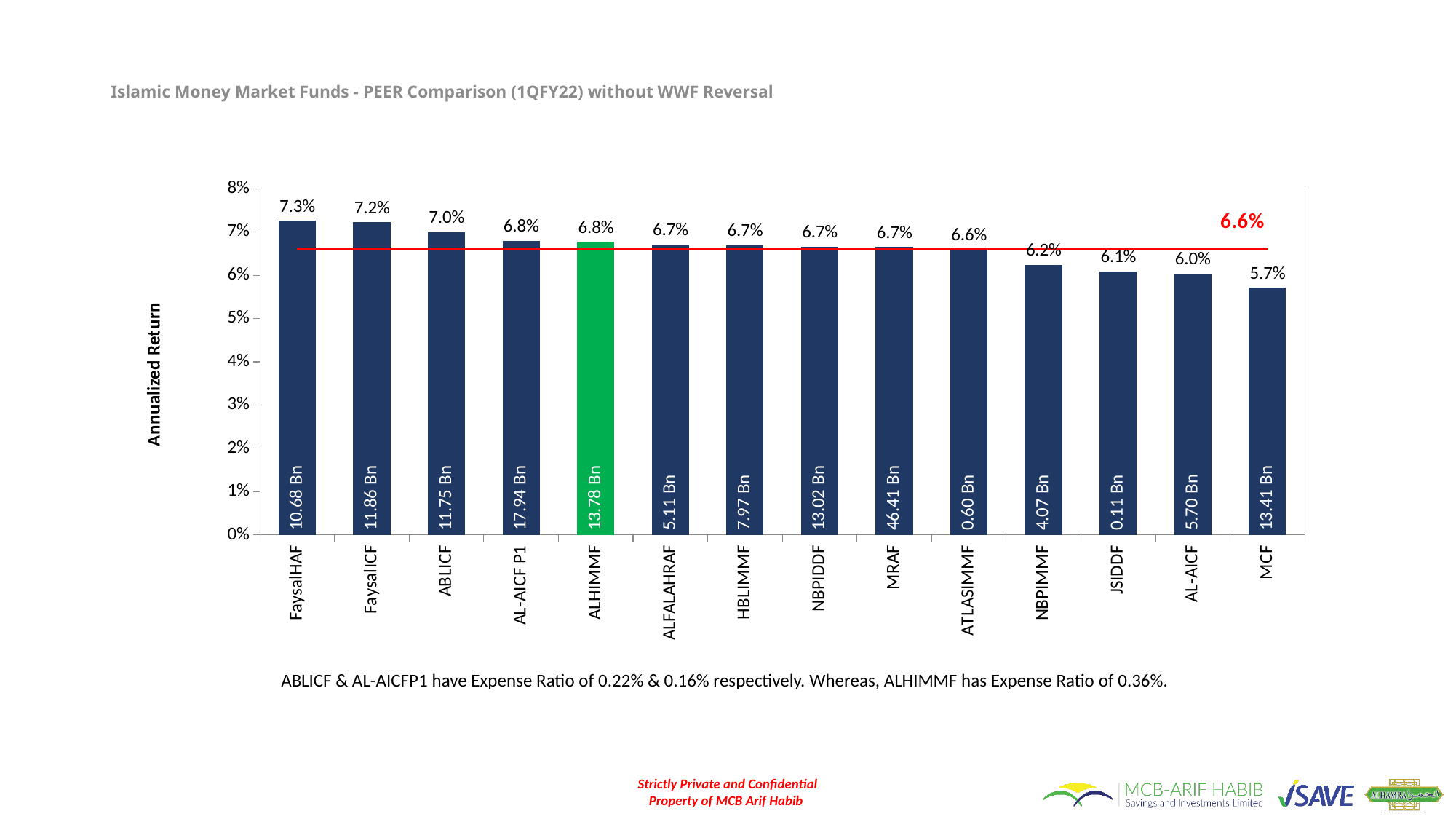
Which fund has the highest annualized return? FaysalHAF How many funds are shown on the chart? 14 What is the annualized return for MCF? 5.7% What is the difference between the annualized return of FaysalHAF and MCF? 1.6% Which has a higher annualized return, ABLICF or NBPIMMF? ABLICF What kind of chart is shown on the slide? bar chart Do the annualized returns rise or fall from left to right along the x axis? fall Which fund has the lowest annualized return? MCF What fund size is printed inside the MRAF bar? 46.41 Bn What is the annualized return for ALHIMMF? 6.8% Is the annualized return for JSIDDF greater or less than 7%? less What value is labelled on the red horizontal line across the chart? 6.6%